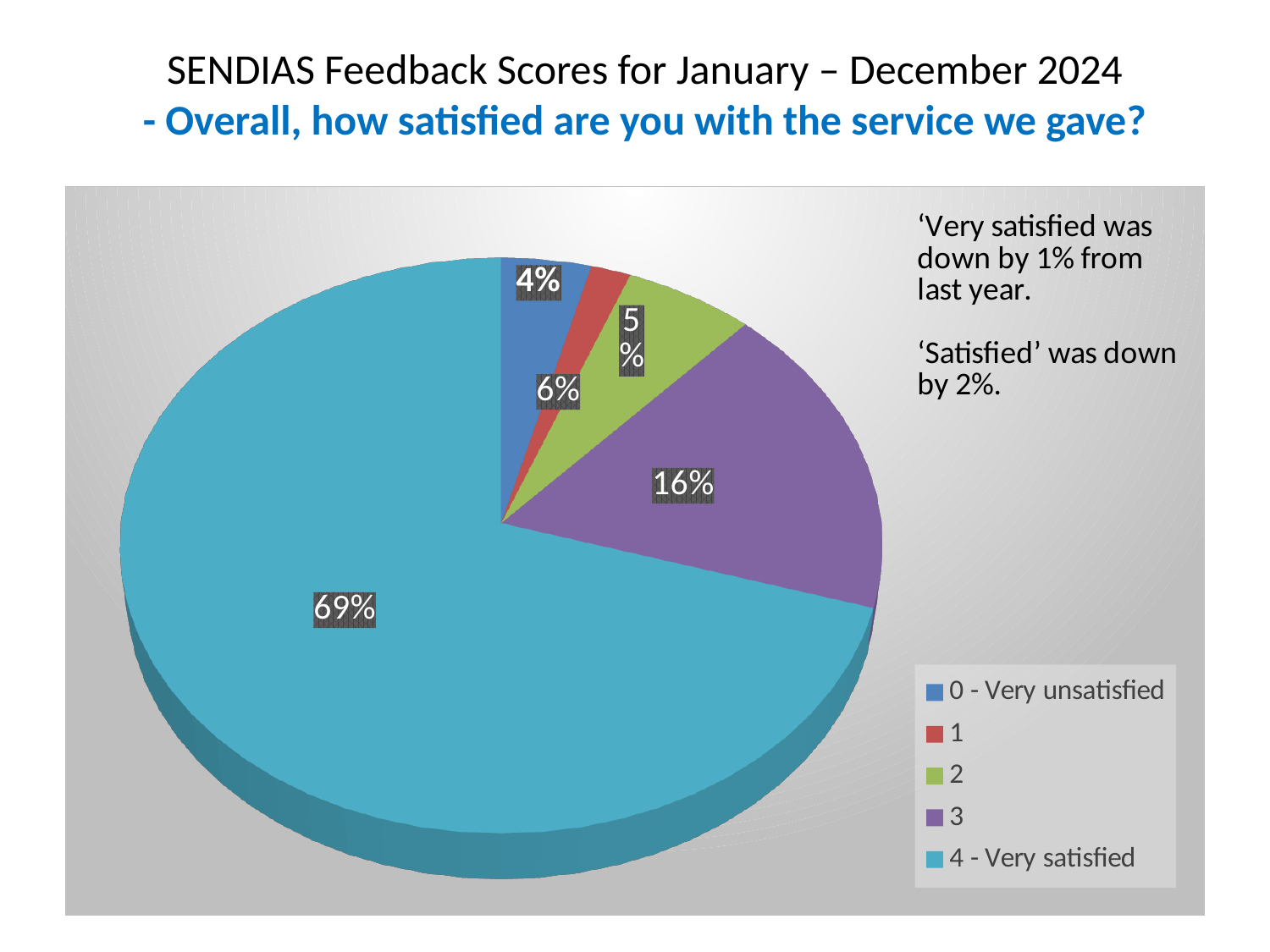
What percentage of respondents answered '4 - Very satisfied'? 69% How many categories does the pie chart show? 5 Which colour represents '4 - Very satisfied' in the legend? light blue What kind of chart is shown on the slide? pie chart What question does the chart title say the feedback scores relate to? Overall, how satisfied are you with the service we gave? What percentage of respondents answered '0 - Very unsatisfied'? 4% What is the combined share of '4 - Very satisfied' and score 3? 85% What percentage of respondents gave a score of 3? 16% Which category has the largest share of the pie? 4 - Very satisfied Which is larger, the share for score 3 or the share for '0 - Very unsatisfied'? 3 What is the difference in percentage points between '4 - Very satisfied' and score 3? 53